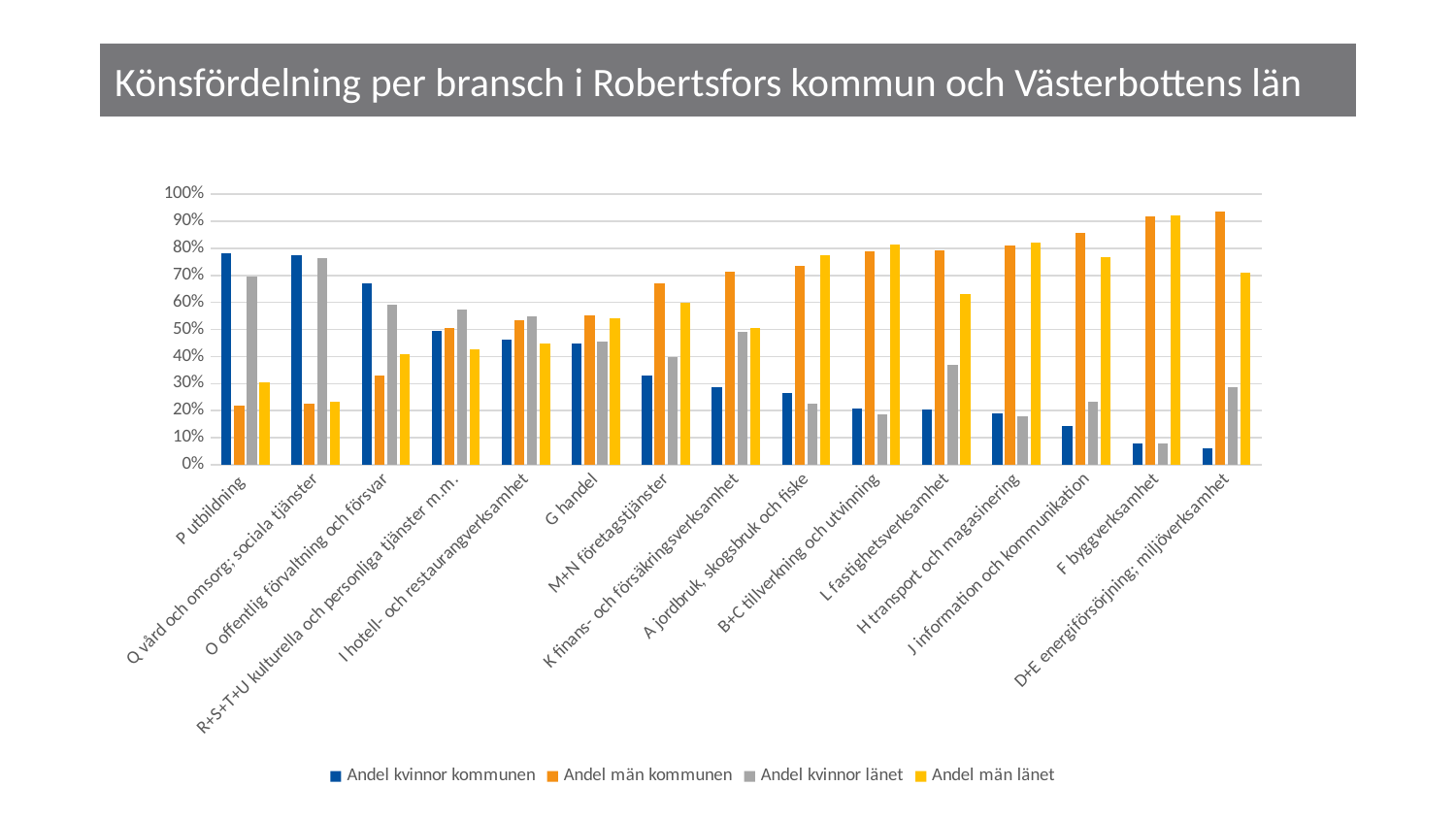
Is the value of Andel kvinnor länet for L fastighetsverksamhet greater or less than 50%? less What kind of chart is shown on the slide? Bar chart How many industry categories are shown on the x axis? 15 Is the value of Andel män kommunen for P utbildning greater or less than 30%? less For G handel, which is larger: Andel kvinnor kommunen or Andel män kommunen? Andel män kommunen What is the title of the slide? Könsfördelning per bransch i Robertsfors kommun och Västerbottens län Is the value of Andel män länet for B+C tillverkning och utvinning greater or less than 70%? greater How many series does the legend list? 4 For F byggverksamhet, which is larger: Andel kvinnor kommunen or Andel män kommunen? Andel män kommunen Do the values of Andel kvinnor kommunen generally rise or fall from left to right along the x axis? fall